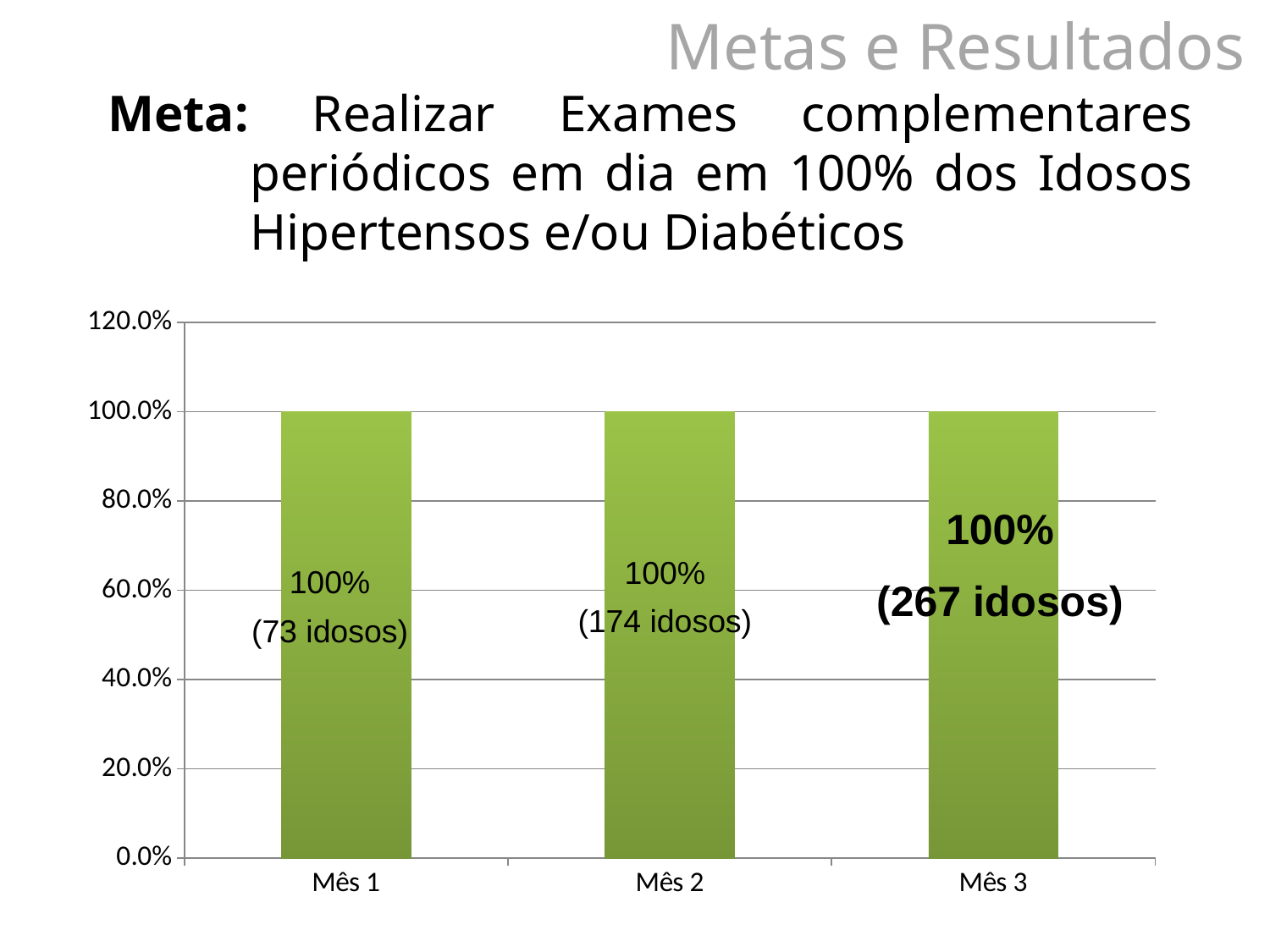
What is the value for Mês 1? 100% What is the value for Mês 3? 100% Is the value for Mês 2 greater or less than 80.0%? greater What kind of chart is shown on the slide? bar chart Which has more idosos in its data label, Mês 2 or Mês 3? Mês 3 What is the difference between the number of idosos for Mês 2 and Mês 1? 101 What is the value for Mês 2? 100% How many categories are shown on the x axis? 3 Which month has the smallest number of idosos in its data label? Mês 1 How many idosos are indicated in the data label for Mês 3? 267 idosos Which month has the largest number of idosos in its data label? Mês 3 How many idosos are indicated in the data label for Mês 1? 73 idosos